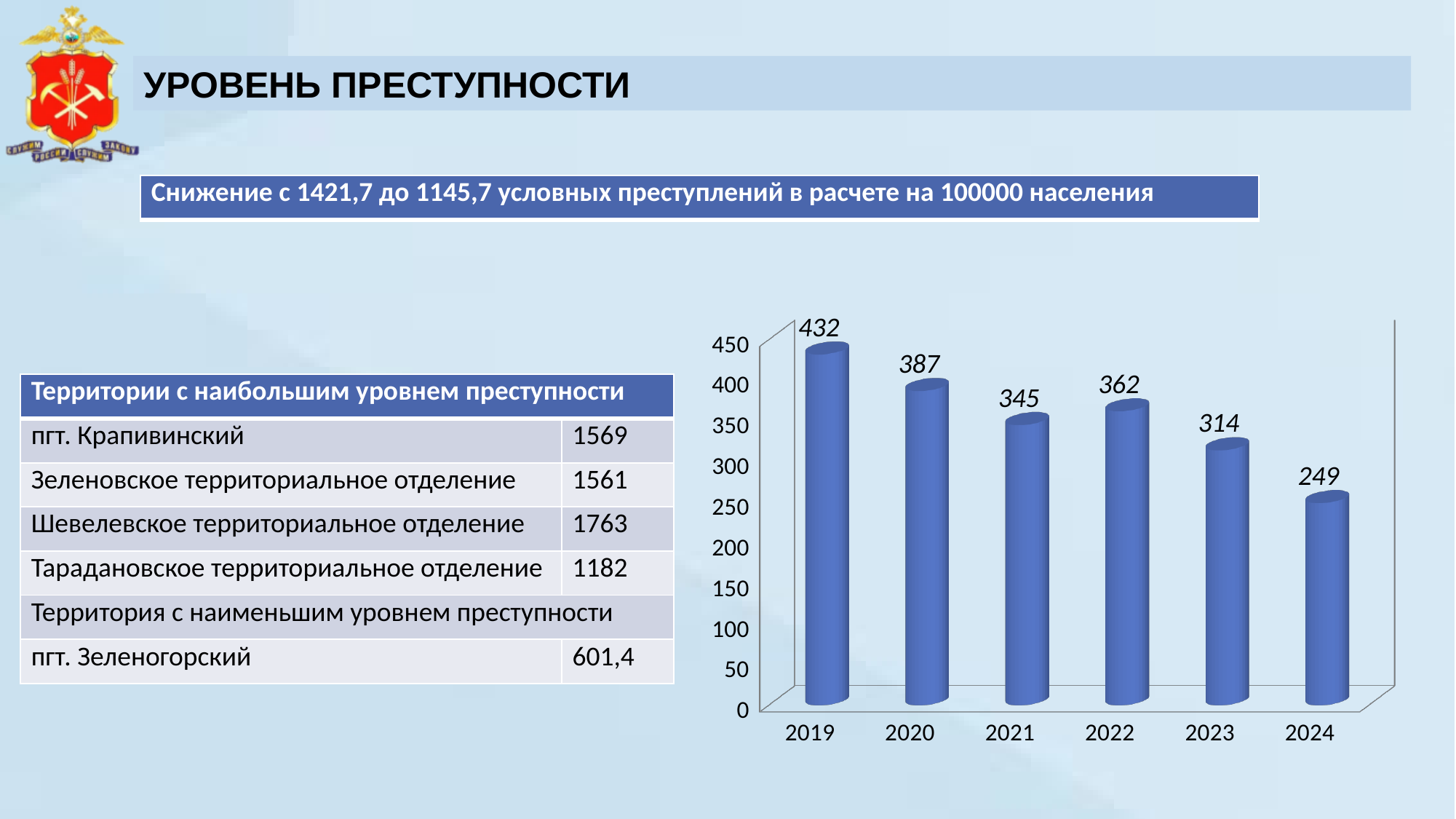
What is the value shown for 2019? 432 What is the value shown for 2022? 362 What is the value shown for 2024? 249 Which year has the highest value in the chart? 2019 What is the difference between the values for 2019 and 2024? 183 Which year has the lowest value in the chart? 2024 How many years are shown on the x axis of the chart? 6 Is the value for 2023 greater or less than 300? greater What kind of chart is shown on the slide? bar chart Do the values generally rise or fall from 2019 to 2024? fall Which is larger, the value for 2020 or the value for 2023? 2020 What is the difference between the values for 2021 and 2022? 17